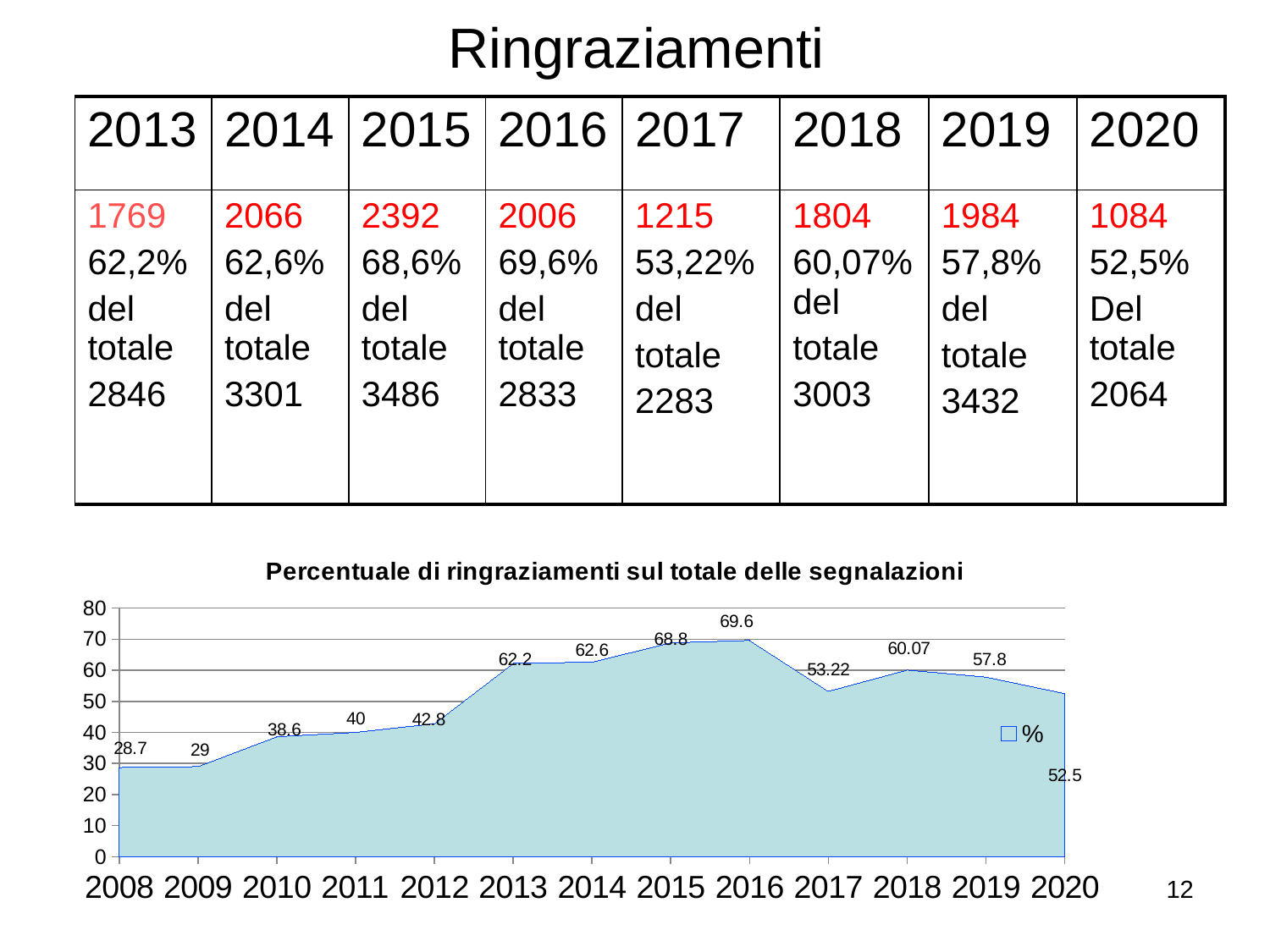
What is the value for 2017 in the chart? 53.22 Which is larger in the chart, the value for 2013 or the value for 2012? 2013 What kind of chart is shown on the slide? area chart What is the difference between the values for 2018 and 2017 in the chart? 6.85 Is the value for 2010 greater or less than 30? greater What is the value for 2016 in the chart? 69.6 How many years are plotted on the x axis of the chart? 13 Which year has the highest value in the chart? 2016 What is the title of the chart? Percentuale di ringraziamenti sul totale delle segnalazioni What is the value for 2008 in the chart? 28.7 What is the value for 2020 in the chart? 52.5 Which year has the lowest value in the chart? 2008